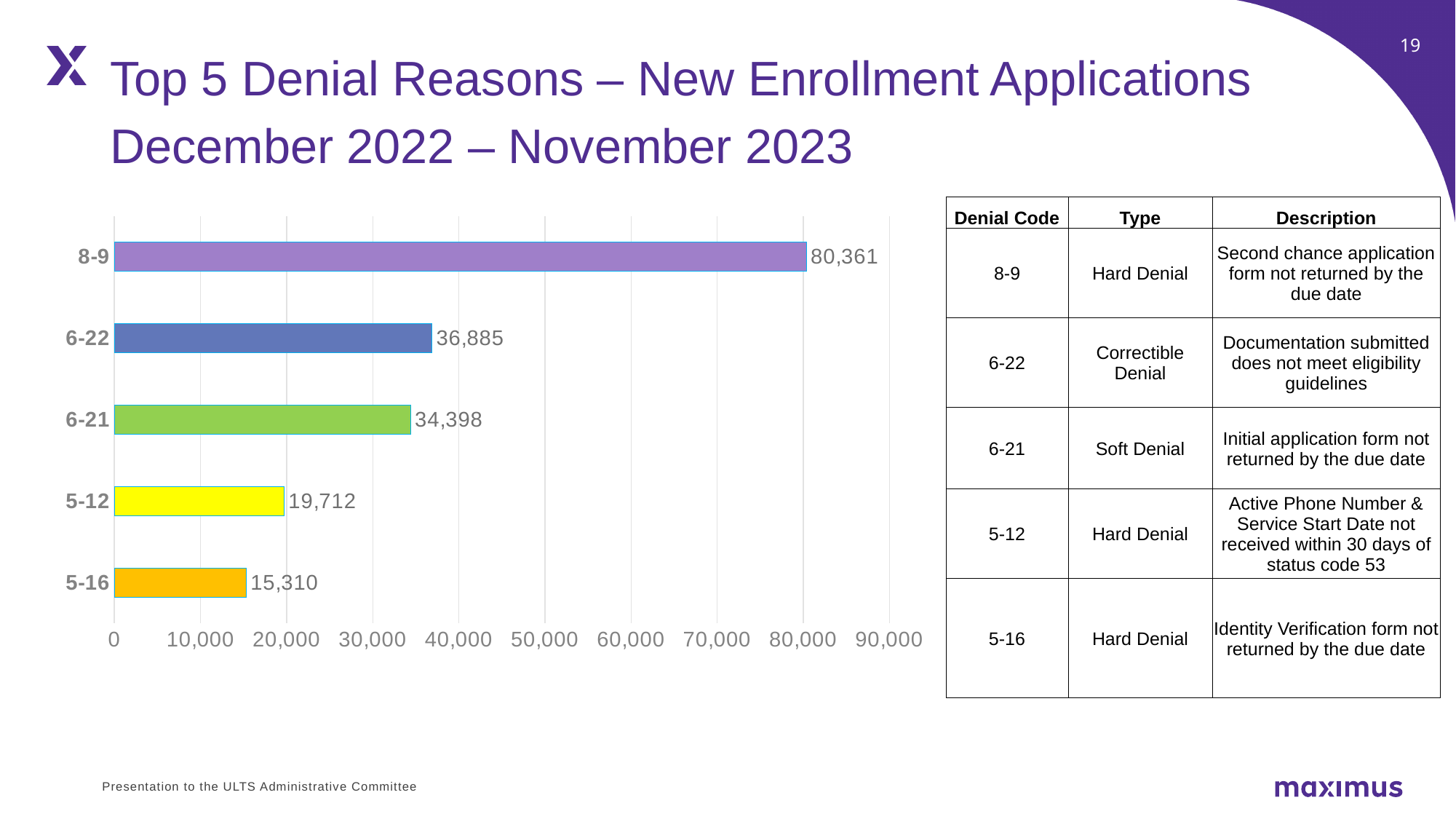
How many denial codes are shown in the chart? 5 Which is larger, the value for 5-12 or the value for 5-16? 5-12 Is the value for 6-21 greater or less than 30,000? greater What is the difference between the values for 8-9 and 5-16? 65,051 What is the highest value shown on the chart's horizontal axis? 90,000 Which denial code has the highest value? 8-9 What kind of chart is shown on the slide? bar chart What is the value for denial code 6-22? 36,885 Which denial code has the lowest value? 5-16 What is the difference between the values for 6-22 and 6-21? 2,487 What is the value for denial code 8-9? 80,361 What is the value for denial code 5-16? 15,310